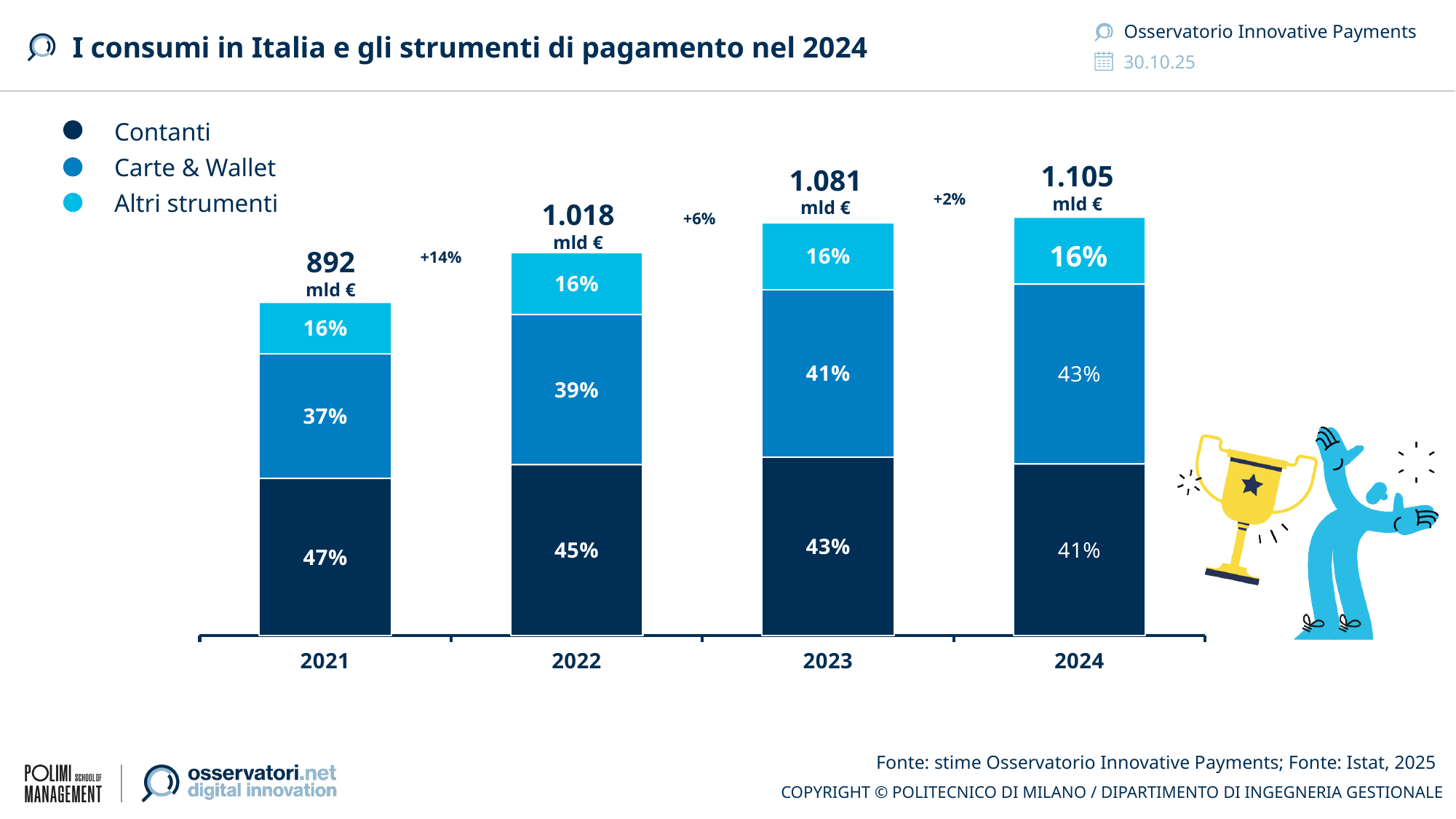
How many years are shown on the x axis? 4 Which year has the highest total consumption value? 2024 Which year has the lowest total consumption value? 2021 What percentage share does Contanti have in 2021? 47% What percentage share does Altri strumenti have in 2022? 16% What is the total consumption value shown above the bar for 2024? 1.105 mld € What percentage share does Carte & Wallet have in 2023? 41% Does the share of Contanti rise or fall from 2021 to 2024? Fall In 2024, which is larger: the share of Contanti or the share of Carte & Wallet? Carte & Wallet What kind of chart is shown on the slide? Stacked bar chart How many series does the legend list? 3 What is the percentage growth shown between 2021 and 2022? +14%